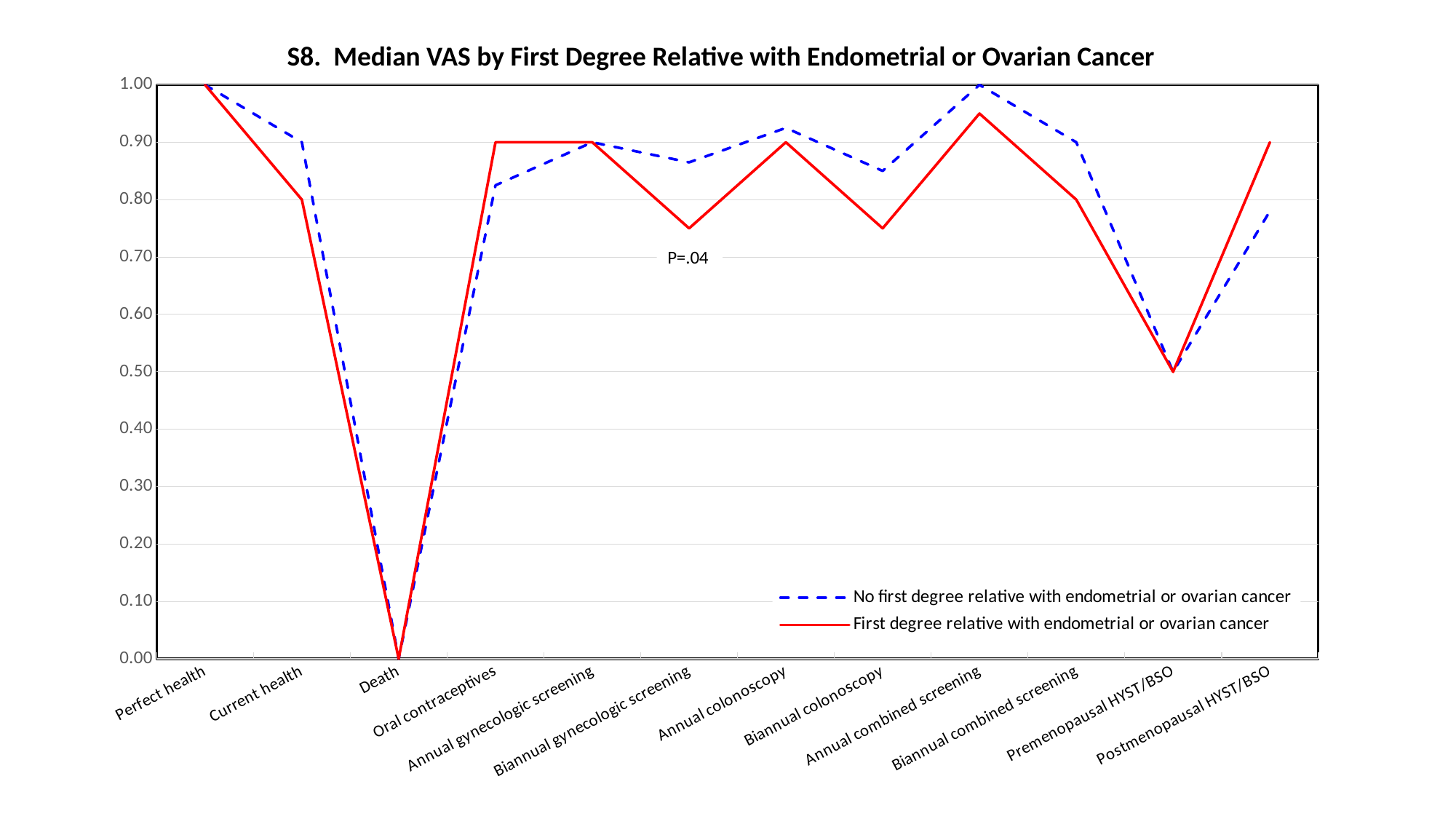
How many series does the legend list? 2 How many categories are shown along the x axis? 12 Is the value for Biannual colonoscopy in the 'First degree relative with endometrial or ovarian cancer' series greater or less than 0.80? less What is the difference between the Postmenopausal HYST/BSO and Premenopausal HYST/BSO values for the 'First degree relative with endometrial or ovarian cancer' series? 0.40 Is the value for Premenopausal HYST/BSO in the 'No first degree relative with endometrial or ovarian cancer' series greater or less than 0.60? less What is the median VAS for Death for the 'First degree relative with endometrial or ovarian cancer' series? 0.00 Which category has the lowest value for the 'First degree relative with endometrial or ovarian cancer' series? Death At Biannual gynecologic screening, which series has the higher median VAS? No first degree relative with endometrial or ovarian cancer What is the median VAS for Oral contraceptives for the 'First degree relative with endometrial or ovarian cancer' series? 0.90 What kind of chart is shown on the slide? line chart Which category has the highest value for the 'First degree relative with endometrial or ovarian cancer' series? Perfect health What is the median VAS for Premenopausal HYST/BSO for the 'First degree relative with endometrial or ovarian cancer' series? 0.50